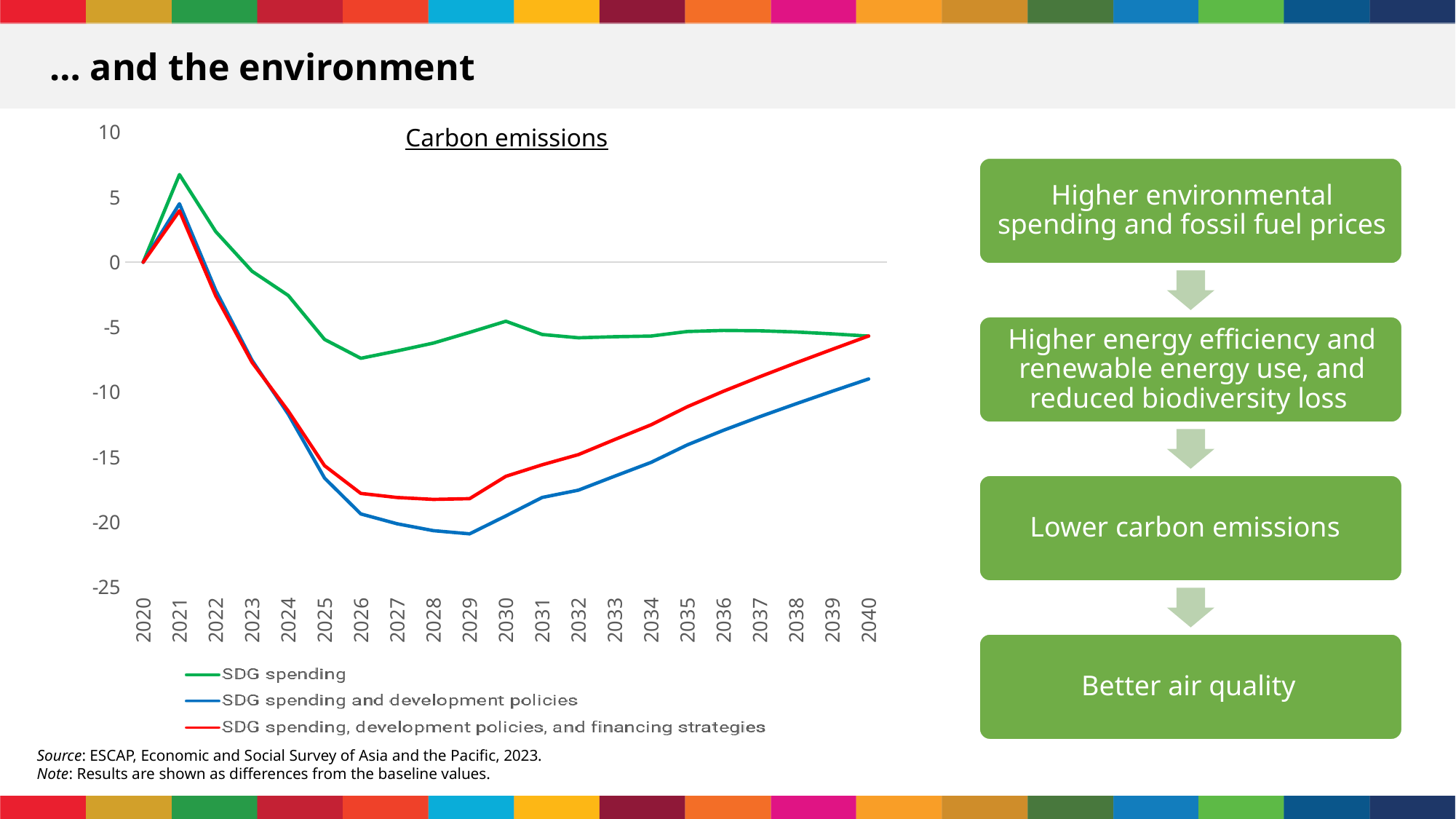
In 2035, which is higher: SDG spending or SDG spending and development policies? SDG spending How many years are shown on the x axis of the Carbon emissions chart? 21 How many series does the legend of the Carbon emissions chart list? 3 In which year does the SDG spending series reach its lowest value? 2026 Is the value for SDG spending in 2021 greater or less than 5? greater In which year does the SDG spending and development policies series reach its lowest value? 2029 What is the value of the SDG spending series in 2020? 0 Is the value for SDG spending, development policies, and financing strategies in 2026 greater or less than -15? less Which series has the lowest value in 2029? SDG spending and development policies What kind of chart is the Carbon emissions chart? line chart Does the SDG spending and development policies series rise or fall from 2029 to 2040? rise Which series has the highest value in 2021? SDG spending